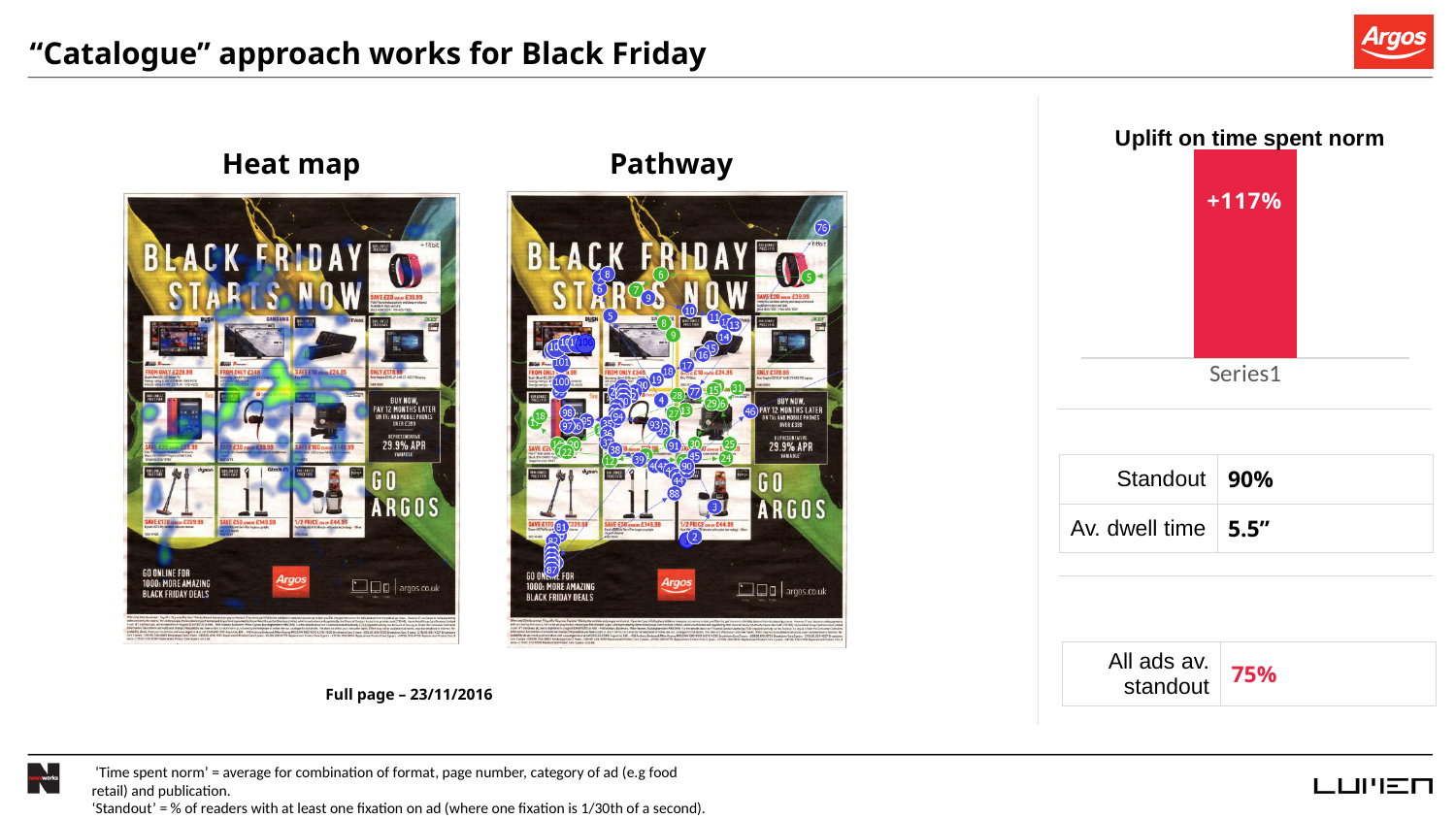
What type of chart is shown under the title "Uplift on time spent norm"? bar chart What is the title of the chart on the slide? Uplift on time spent norm What is the uplift on time spent norm for Series1? +117% What value is printed on the bar in the "Uplift on time spent norm" chart? +117% What is the category label shown on the x axis of the "Uplift on time spent norm" chart? Series1 How many bars are plotted in the "Uplift on time spent norm" chart? 1